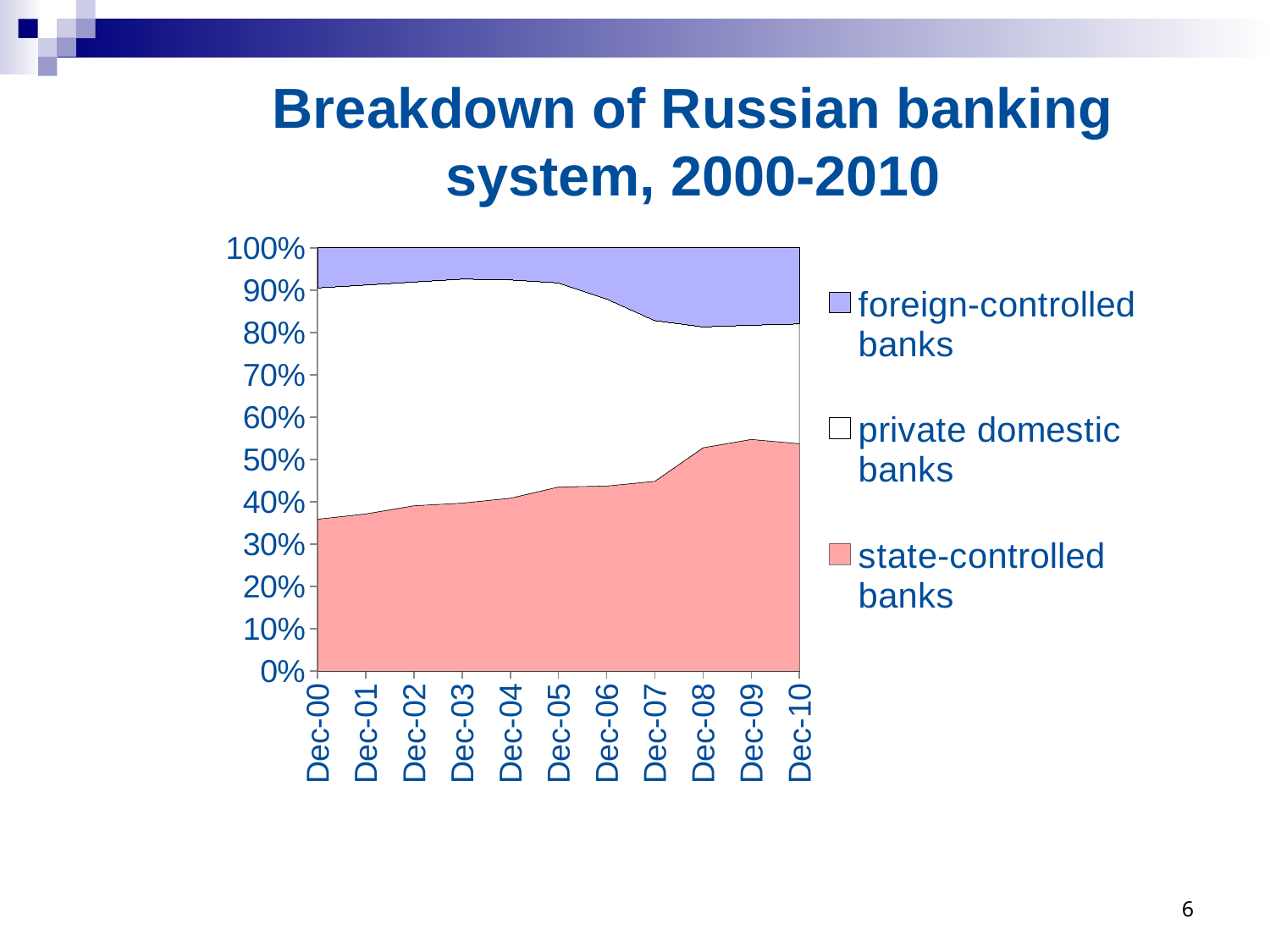
At which time point is the share of state-controlled banks lowest? Dec-00 What kind of chart is shown on the slide? Stacked area chart How many series does the legend list? 3 At Dec-10, which is larger: the share of state-controlled banks or the share of foreign-controlled banks? state-controlled banks Does the share of state-controlled banks rise or fall from Dec-00 to Dec-10? rise Which series is shown in the pink/red area at the bottom of the chart? state-controlled banks Is the share of state-controlled banks at Dec-10 greater or less than 50%? greater Is the share of state-controlled banks at Dec-00 greater or less than 40%? less Is the share of foreign-controlled banks at Dec-10 greater or less than 10%? greater How many time points are shown on the x axis? 11 What is the title of the chart? Breakdown of Russian banking system, 2000-2010 Does the share of private domestic banks rise or fall from Dec-00 to Dec-10? fall